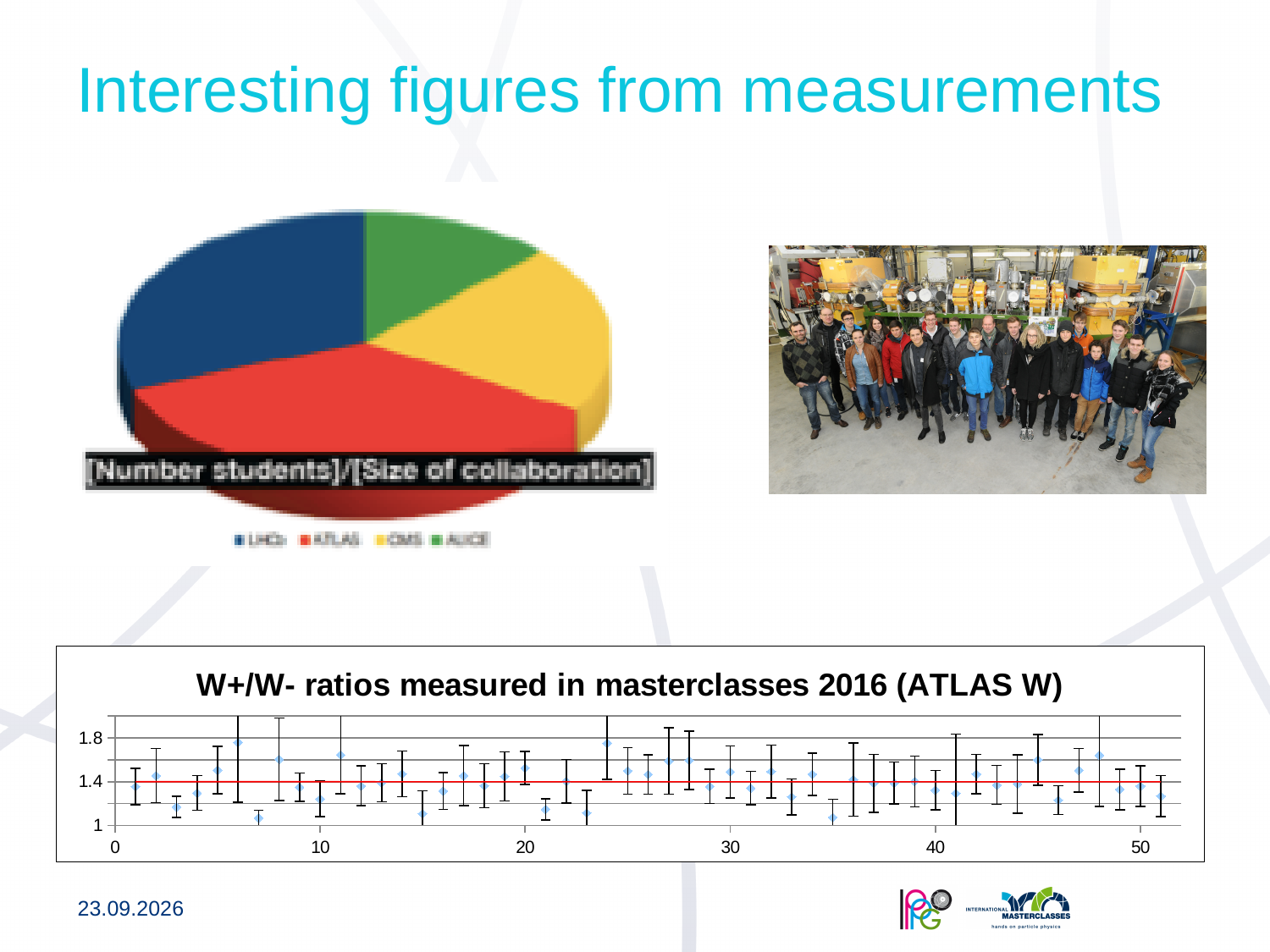
How many entries does the legend of the top-left pie chart list? 4 What kind of chart is the bottom chart (W+/W- ratios)? scatter chart In the top-left pie chart, which colour is the smallest slice? green What is the title of the bottom chart? W+/W- ratios measured in masterclasses 2016 (ATLAS W) What kind of chart is the top-left chart ([Number students]/[Size of collaboration])? pie chart In the bottom chart, is the value of the point at x = 7 greater or less than 1.4? less In the bottom chart, is the value of the point at x = 35 greater or less than 1.4? less How many slices does the top-left pie chart have? 4 In the bottom chart, is the value of the point at x = 24 greater or less than 1.4? greater In the bottom chart, which point has the larger value: the one at x = 6 or the one at x = 7? x = 6 In the bottom chart, at what value is the horizontal red line drawn? 1.4